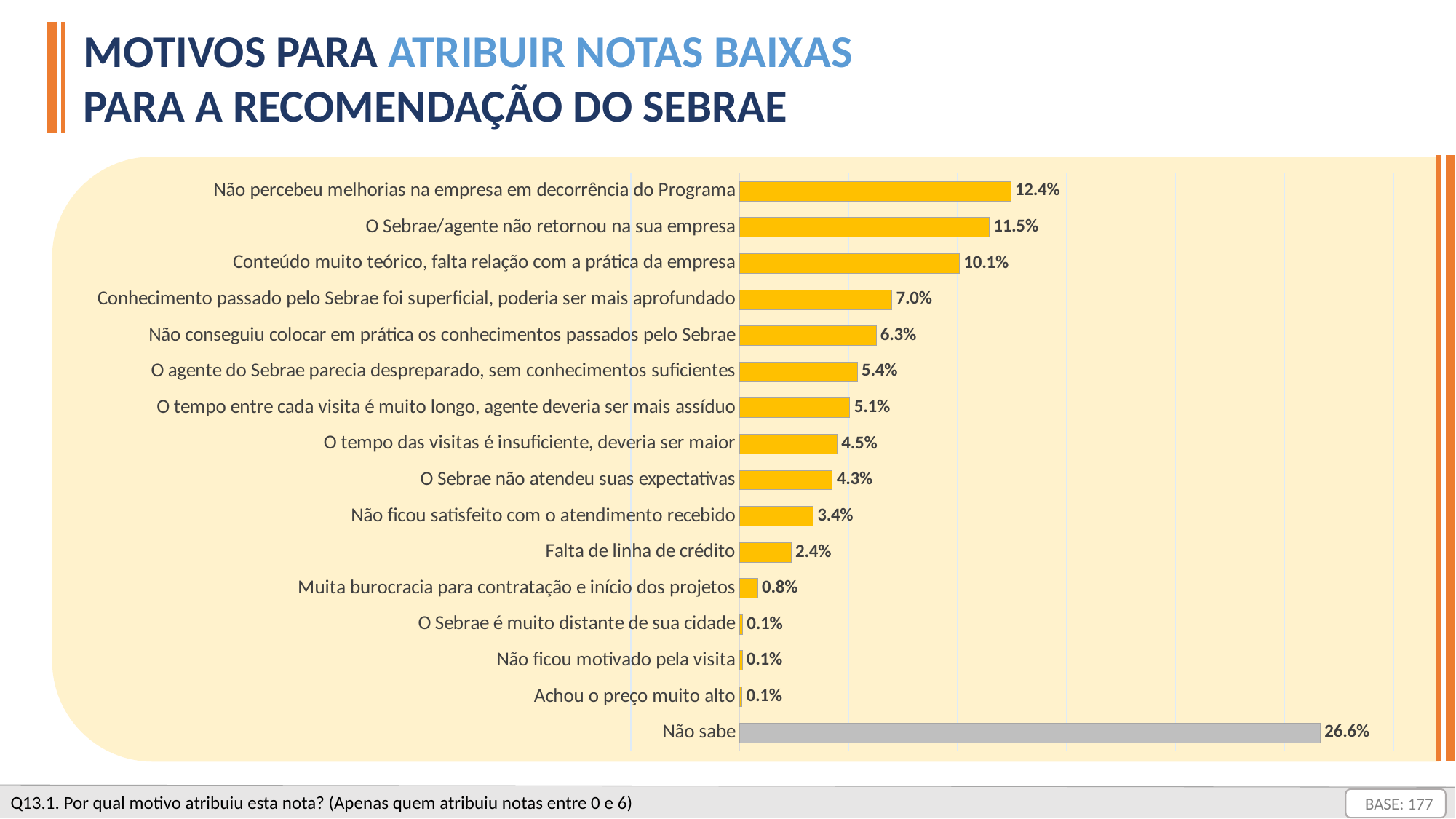
Which category has the highest value in the chart? Não sabe What is the value for "Falta de linha de crédito"? 2.4% What is the difference between the values for "Não percebeu melhorias na empresa em decorrência do Programa" and "O Sebrae/agente não retornou na sua empresa"? 0.9% What is the value for "Não percebeu melhorias na empresa em decorrência do Programa"? 12.4% Which is larger: the value for "Conteúdo muito teórico, falta relação com a prática da empresa" or the value for "Conhecimento passado pelo Sebrae foi superficial, poderia ser mais aprofundado"? Conteúdo muito teórico, falta relação com a prática da empresa How many categories are shown in the chart? 16 What is the difference between the values for "Não sabe" and "Não percebeu melhorias na empresa em decorrência do Programa"? 14.2% What is the value for "Muita burocracia para contratação e início dos projetos"? 0.8% What kind of chart is shown on the slide? bar chart What is the value for "Não sabe"? 26.6% What colour is the bar for "Não sabe"? grey What is the value for "O Sebrae/agente não retornou na sua empresa"? 11.5%